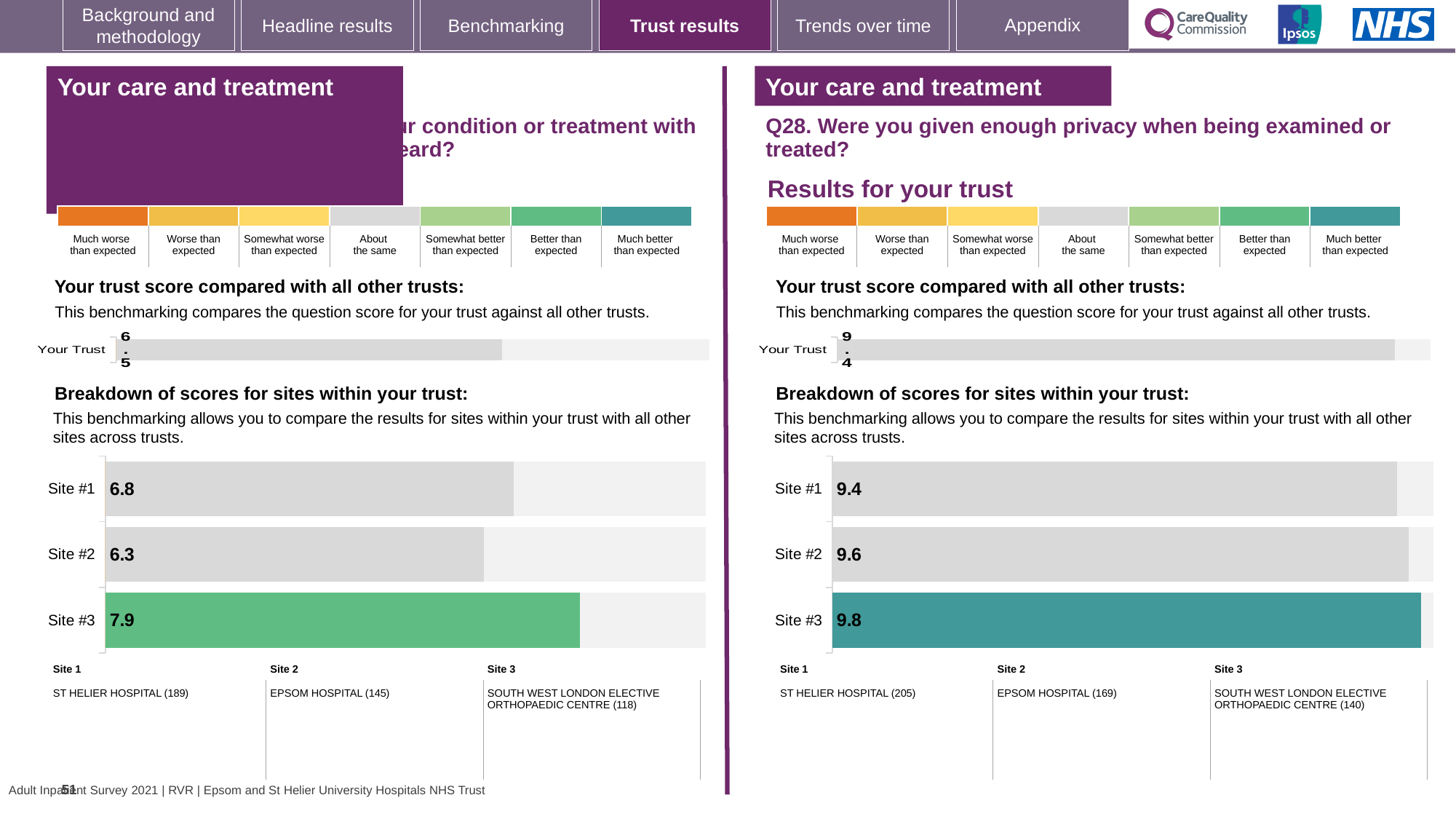
In the right-hand Q28 site breakdown chart, what is the difference between the scores for Site #3 and Site #1? 0.4 In the left-hand site breakdown chart, which site has the highest score? Site #3 In the right-hand Q28 site breakdown chart, what is the score for Site #3? 9.8 How many sites are shown in the right-hand Q28 site breakdown chart? 3 In the left-hand site breakdown chart, what is the score for Site #3? 7.9 In the right-hand Q28 site breakdown chart, what is the score for Site #1? 9.4 In the right-hand Q28 site breakdown chart, which site has the lowest score? Site #1 In the left-hand site breakdown chart, which has the larger score, Site #1 or Site #2? Site #1 In the left-hand site breakdown chart, what is the difference between the scores for Site #3 and Site #2? 1.6 What type of chart is used for the site breakdown on the right-hand Q28 panel? Bar chart In the left-hand site breakdown chart, what is the score for Site #2? 6.3 In the left-hand site breakdown chart, which site has the lowest score? Site #2